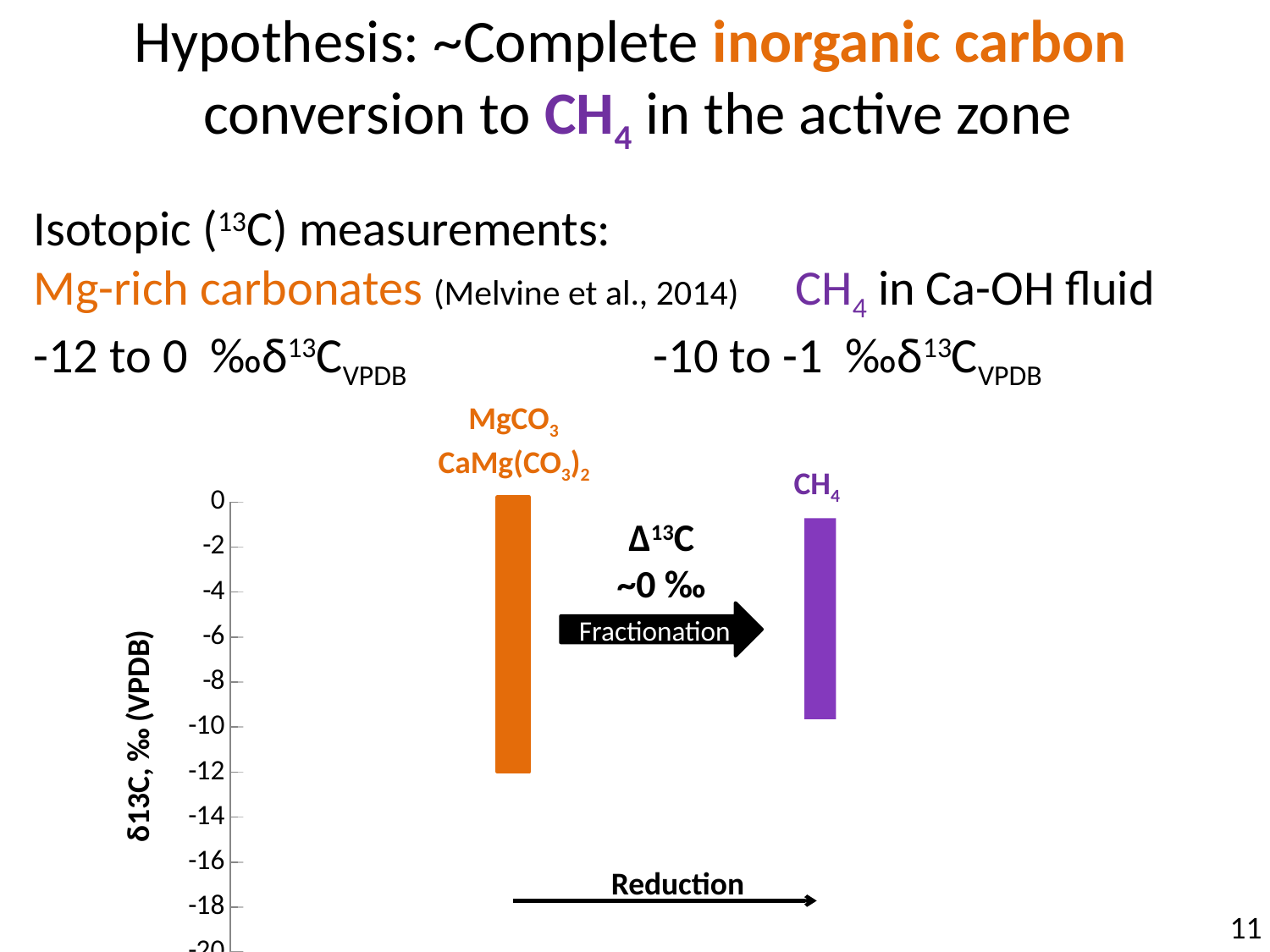
What colour is the CH4 bar? purple What is the y-axis label of the chart? δ13C, ‰ (VPDB) What kind of chart is shown on the slide? bar chart Is the lowest value of the CH4 bar greater or less than -12? greater Which bar has the larger span of δ13C values, the carbonate bar or the CH4 bar? the carbonate bar (MgCO3 / CaMg(CO3)2) How many bars are plotted in the chart? 2 What fractionation (Δ13C) is indicated by the arrow between the carbonate bar and the CH4 bar? ~0 ‰ Is the lowest value of the carbonate bar greater or less than -10? less What range of δ13C values does the Mg-rich carbonate bar (MgCO3 / CaMg(CO3)2) span? -12 to 0 ‰ Which bar reaches the lowest δ13C value, the carbonate bar or the CH4 bar? the carbonate bar (MgCO3 / CaMg(CO3)2) What range of δ13C values does the CH4 bar span? -10 to -1 ‰ What is the lowest tick value shown on the y-axis? -20